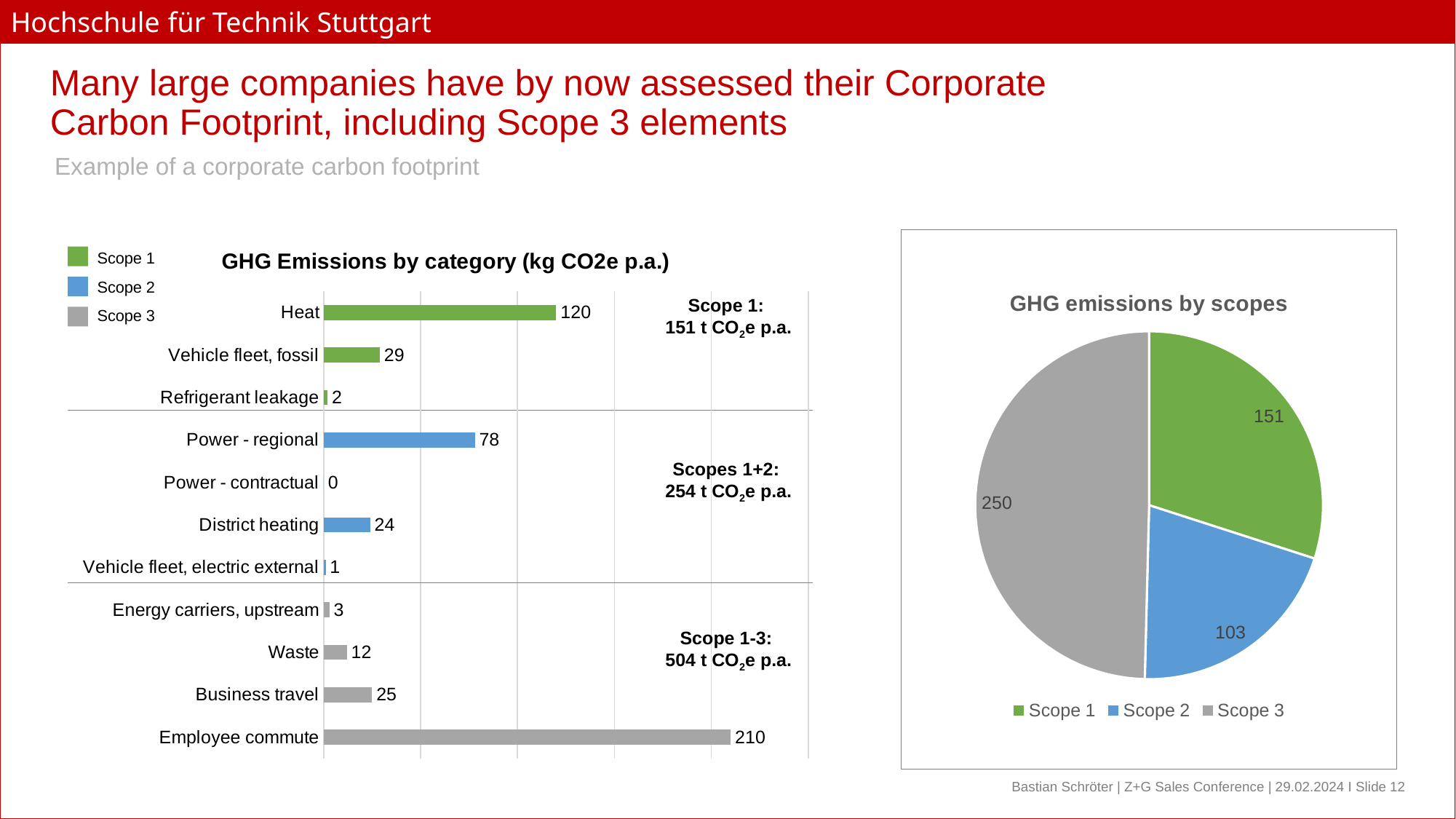
What type of chart is 'GHG Emissions by category (kg CO2e p.a.)'? Bar chart In the chart 'GHG Emissions by category (kg CO2e p.a.)', which category has the highest value? Employee commute In the chart 'GHG Emissions by category (kg CO2e p.a.)', what is the value for Employee commute? 210 In the pie chart 'GHG emissions by scopes', what is the difference between Scope 3 and Scope 1? 99 In the chart 'GHG Emissions by category (kg CO2e p.a.)', what is the difference between Heat and Vehicle fleet, fossil? 91 In the pie chart 'GHG emissions by scopes', what is the value for Scope 2? 103 How many categories are shown in the chart 'GHG Emissions by category (kg CO2e p.a.)'? 11 In the chart 'GHG Emissions by category (kg CO2e p.a.)', which category has the lowest value? Power - contractual In the chart 'GHG Emissions by category (kg CO2e p.a.)', which is larger, Business travel or District heating? Business travel How many series does the legend of the pie chart 'GHG emissions by scopes' list? 3 In the chart 'GHG Emissions by category (kg CO2e p.a.)', what is the value for Power - regional? 78 In the pie chart 'GHG emissions by scopes', which scope has the largest slice? Scope 3